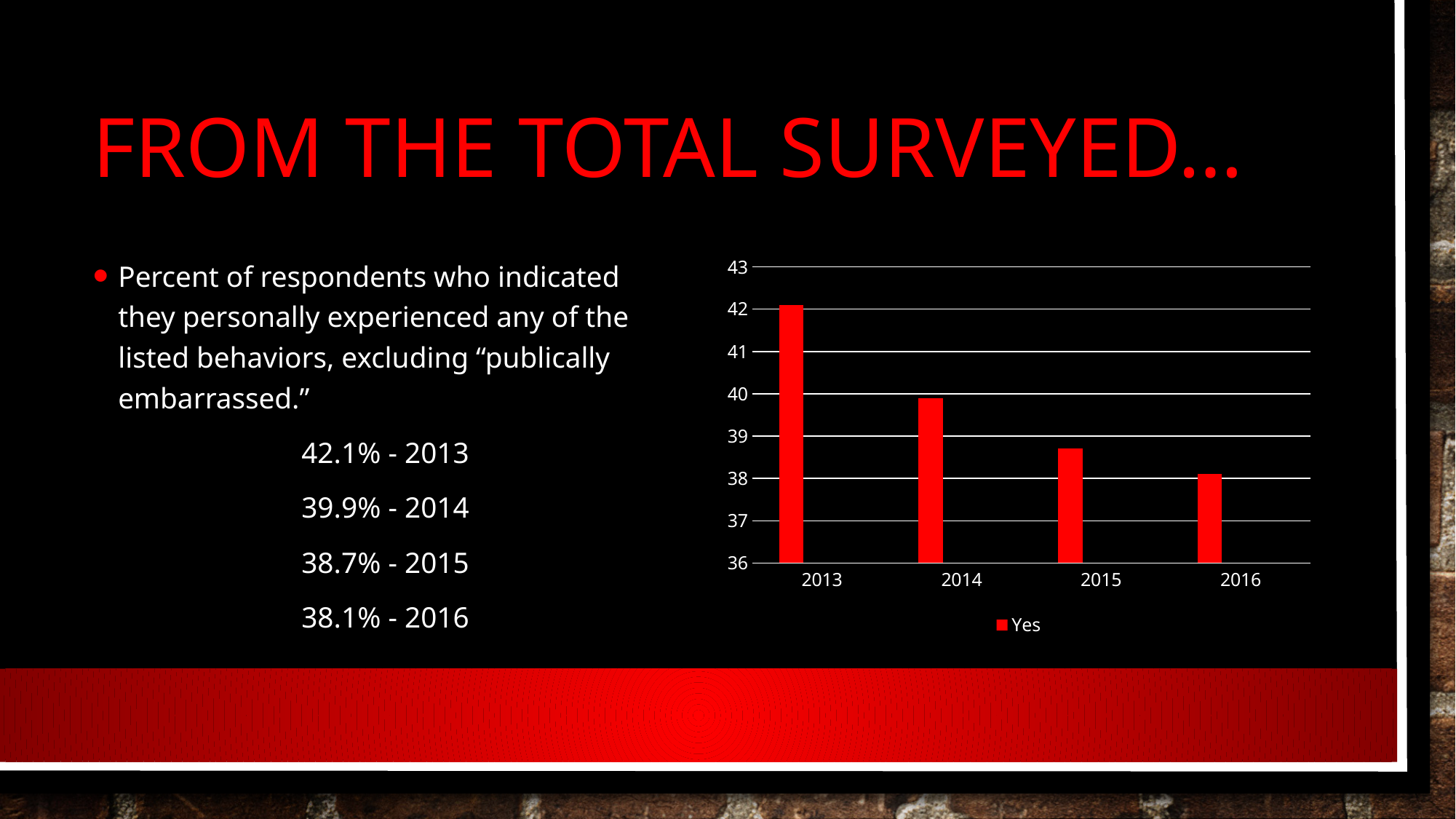
What is the difference between the values for 2013 and 2016? 4% What is the value for 2014 in the bar chart? 39.9% How many series does the chart legend list? 1 What kind of chart is shown on the slide? bar chart What is the value for 2013 in the bar chart? 42.1% How many years are shown on the x axis of the chart? 4 Which is larger, the value for 2014 or the value for 2015? 2014 Which year has the highest bar in the chart? 2013 Do the values rise or fall from 2013 to 2016? fall What is the value for 2016 in the bar chart? 38.1% Which year has the lowest bar in the chart? 2016 Is the value for 2015 greater or less than 39? less